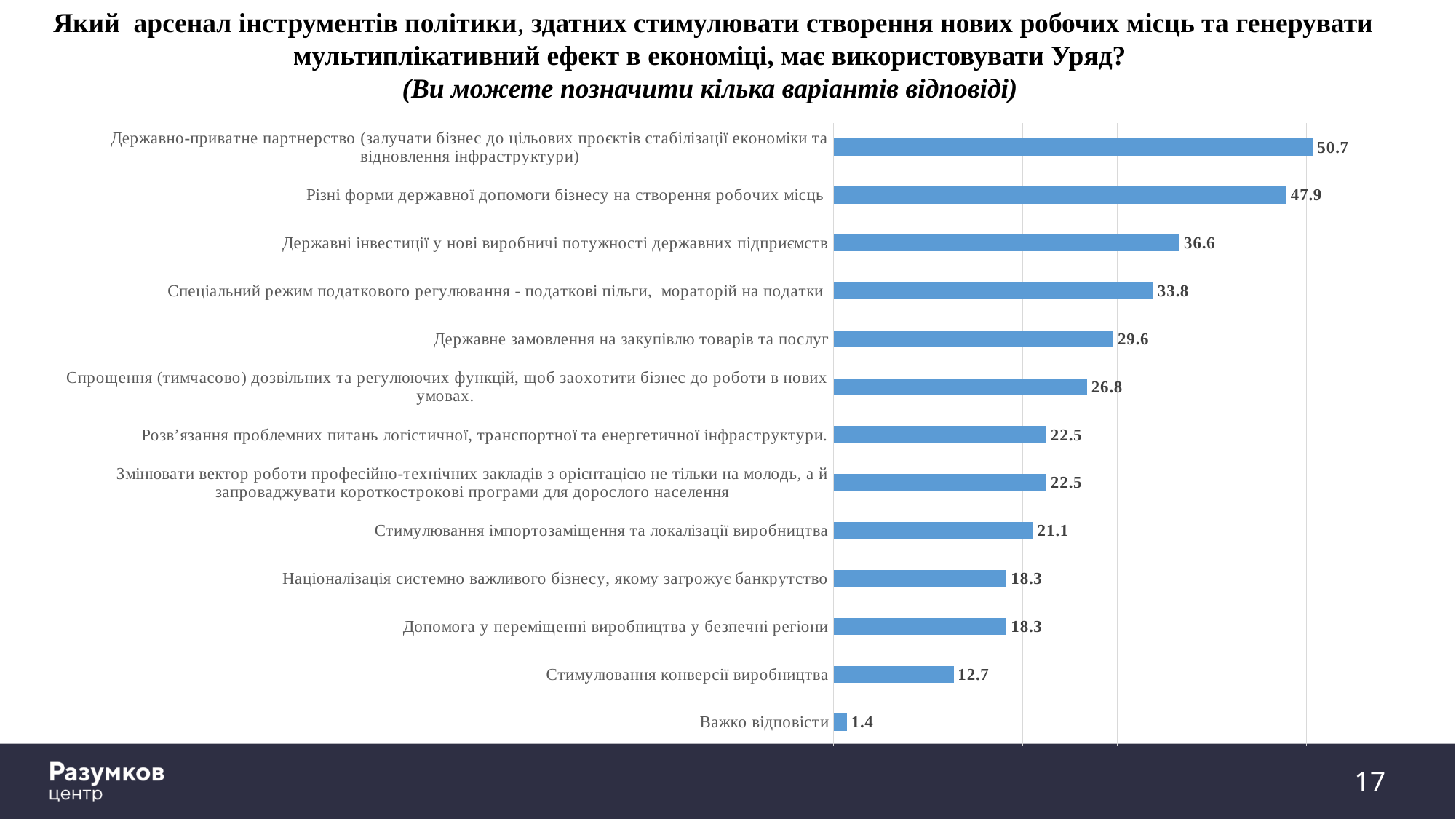
What is the value for "Державно-приватне партнерство (залучати бізнес до цільових проєктів стабілізації економіки та відновлення інфраструктури)"? 50.7 Which category has the lowest value in the chart? Важко відповісти What is the value for "Допомога у переміщенні виробництва у безпечні регіони"? 18.3 What is the value for "Різні форми державної допомоги бізнесу на створення робочих місць"? 47.9 How many categories (answer options) are plotted in the chart? 13 What is the value for "Державне замовлення на закупівлю товарів та послуг"? 29.6 What is the difference between the values for "Державні інвестиції у нові виробничі потужності державних підприємств" and "Спеціальний режим податкового регулювання - податкові пільги, мораторій на податки"? 2.8 What is the value for "Стимулювання конверсії виробництва"? 12.7 Which is larger: the value for "Стимулювання імпортозаміщення та локалізації виробництва" or the value for "Націоналізація системно важливого бізнесу, якому загрожує банкрутство"? Стимулювання імпортозаміщення та локалізації виробництва What is the difference between the values for "Державно-приватне партнерство" (50.7) and "Різні форми державної допомоги бізнесу на створення робочих місць" (47.9)? 2.8 What type of chart is shown on the slide? bar chart Which category has the highest value in the chart? Державно-приватне партнерство (залучати бізнес до цільових проєктів стабілізації економіки та відновлення інфраструктури)